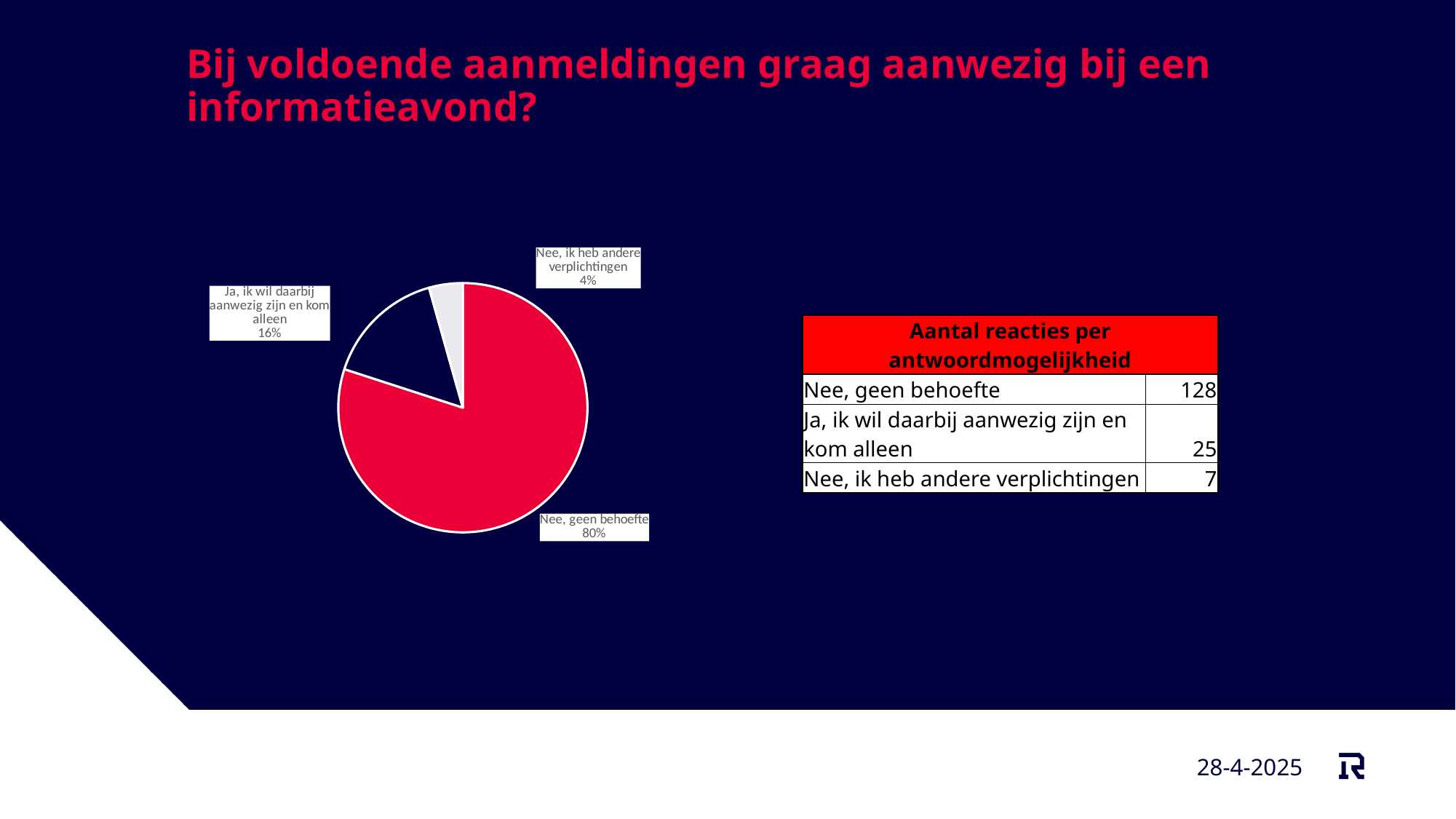
What share of the pie does "Nee, ik heb andere verplichtingen" represent? 4% Which category has the smallest slice of the pie? Nee, ik heb andere verplichtingen According to the table, how many responses were there for "Nee, ik heb andere verplichtingen"? 7 What colour is the largest slice of the pie chart? red How many slices does the pie chart have? 3 Which is larger: the slice for "Ja, ik wil daarbij aanwezig zijn en kom alleen" or the slice for "Nee, ik heb andere verplichtingen"? Ja, ik wil daarbij aanwezig zijn en kom alleen What share of the pie does "Nee, geen behoefte" represent? 80% Which category has the largest slice of the pie? Nee, geen behoefte What share of the pie does "Ja, ik wil daarbij aanwezig zijn en kom alleen" represent? 16% What is the difference in percentage points between the "Nee, geen behoefte" slice and the "Ja, ik wil daarbij aanwezig zijn en kom alleen" slice? 64 percentage points What kind of chart is shown on the slide? pie chart According to the table, how many responses were there for "Nee, geen behoefte"? 128